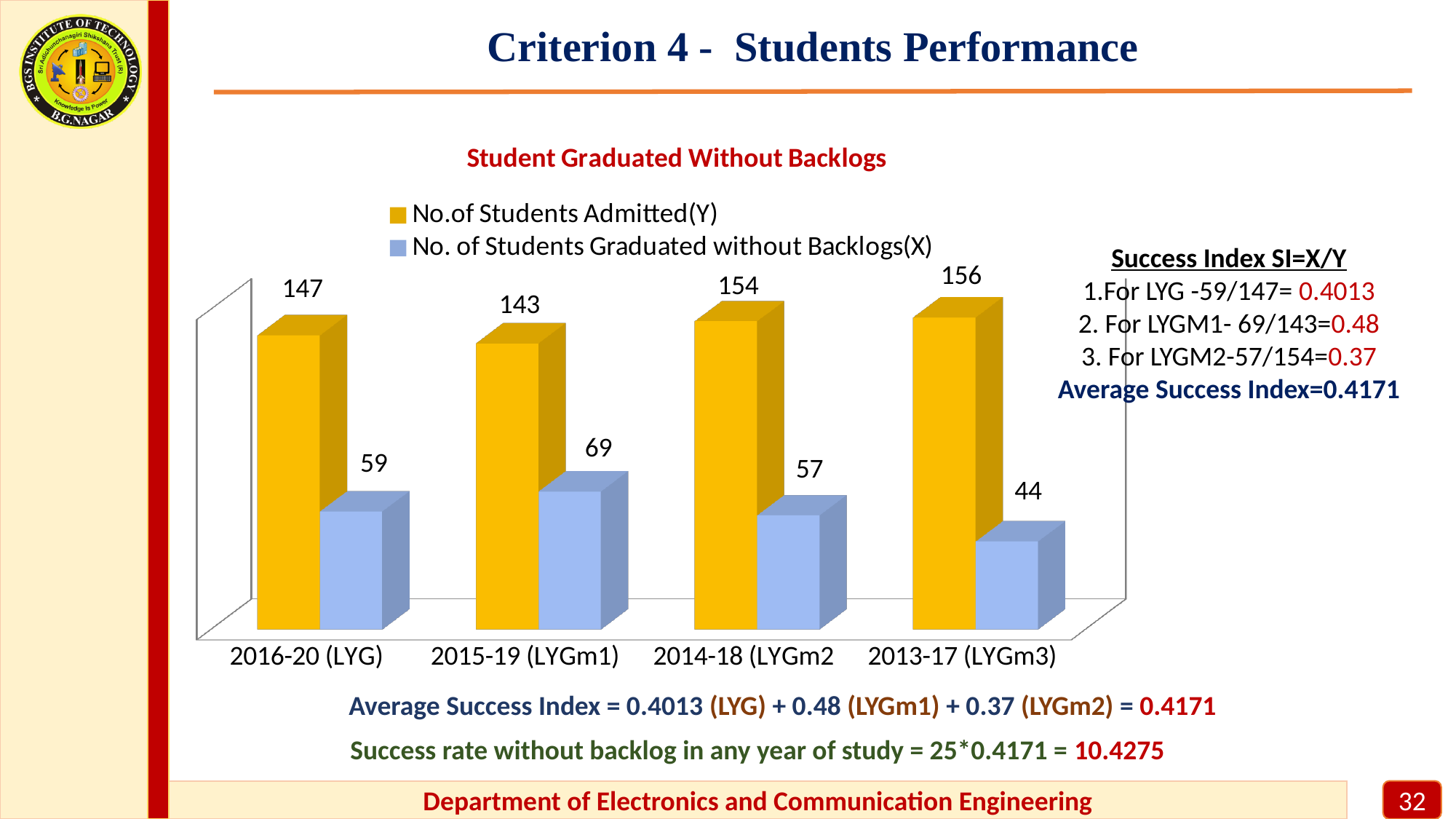
Which category has the highest number of students admitted (Y)? 2013-17 (LYGm3) What is the number of students admitted (Y) for 2016-20 (LYG)? 147 Which colour represents the No.of Students Admitted(Y) series in the chart? yellow How many categories are shown on the x axis of the chart? 4 What is the number of students graduated without backlogs (X) for 2015-19 (LYGm1)? 69 What is the number of students graduated without backlogs (X) for 2013-17 (LYGm3)? 44 Which is larger: the number of students graduated without backlogs for 2016-20 (LYG) or for 2014-18 (LYGm2)? 2016-20 (LYG) Which category has the lowest number of students graduated without backlogs (X)? 2013-17 (LYGm3) What is the title of the chart? Student Graduated Without Backlogs What is the difference between the number of students admitted and the number graduated without backlogs for 2014-18 (LYGm2)? 97 How many series does the chart legend list? 2 What kind of chart is shown on the slide? bar chart